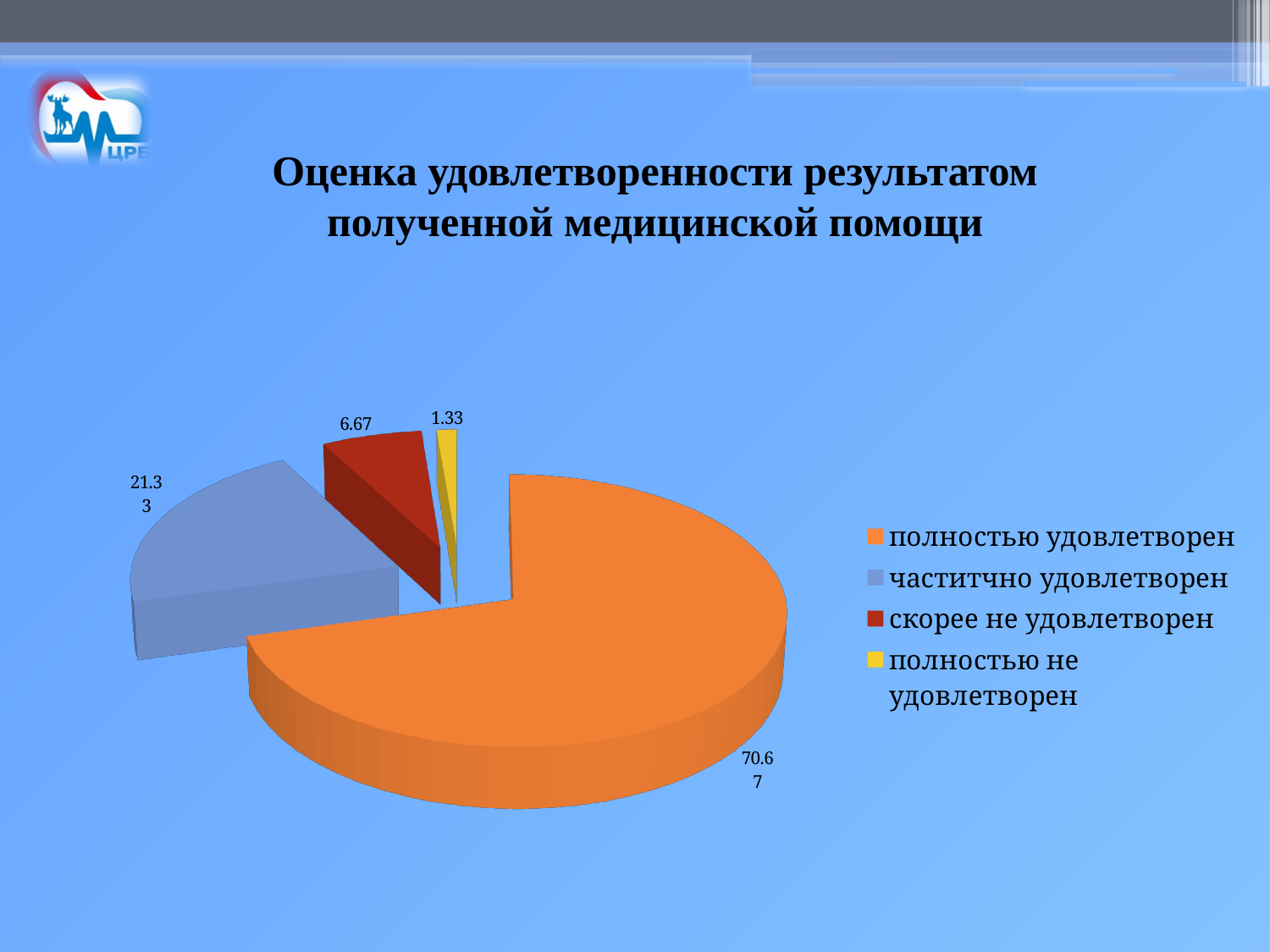
What is the value for the slice "полностью удовлетворен"? 70.67 Which category has the largest slice of the pie? полностью удовлетворен What type of chart is shown on the slide? pie chart What is the title of the slide above the chart? Оценка удовлетворенности результатом полученной медицинской помощи What is the value for the slice "полностью не удовлетворен"? 1.33 What colour is the slice for "частитчно удовлетворен"? blue Which is larger: the value for "скорее не удовлетворен" or the value for "полностью не удовлетворен"? скорее не удовлетворен Which category has the smallest slice of the pie? полностью не удовлетворен What is the value for the slice "скорее не удовлетворен"? 6.67 What is the value for the slice "частитчно удовлетворен"? 21.33 What is the difference between the values for "полностью удовлетворен" and "частитчно удовлетворен"? 49.34 How many slices does the pie chart have? 4